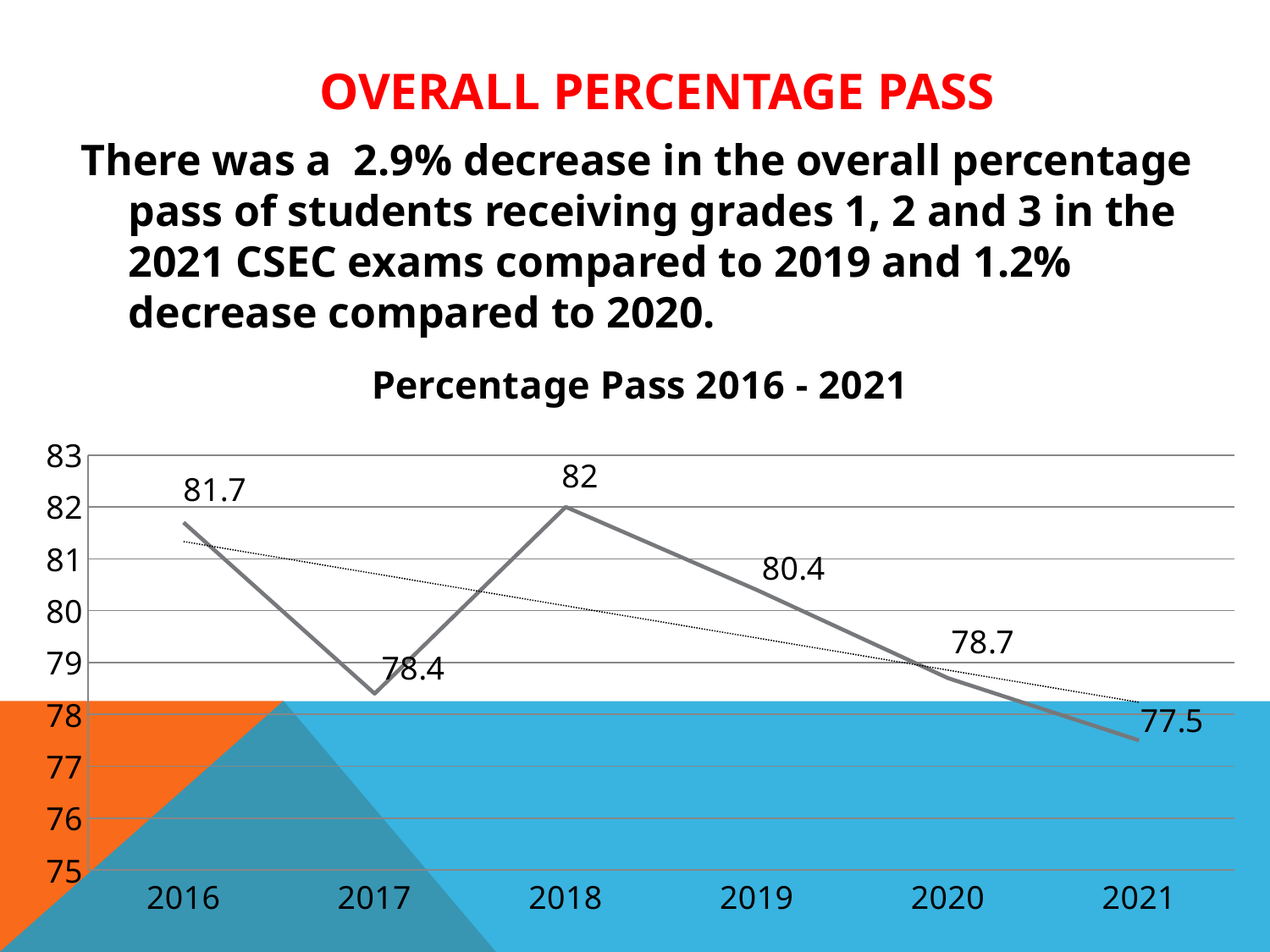
What is the percentage pass for 2020? 78.7 What is the percentage pass for 2018? 82 Which year has the highest percentage pass? 2018 What kind of chart is shown on the slide? line chart Is the value for 2019 greater or less than 80? greater What is the difference between the percentage pass in 2019 and 2021? 2.9 Which year has a higher percentage pass, 2017 or 2020? 2020 What is the title of the chart? Percentage Pass 2016 - 2021 How many years are plotted on the chart? 6 What is the percentage pass for 2016? 81.7 What is the percentage pass for 2021? 77.5 Which year has the lowest percentage pass? 2021